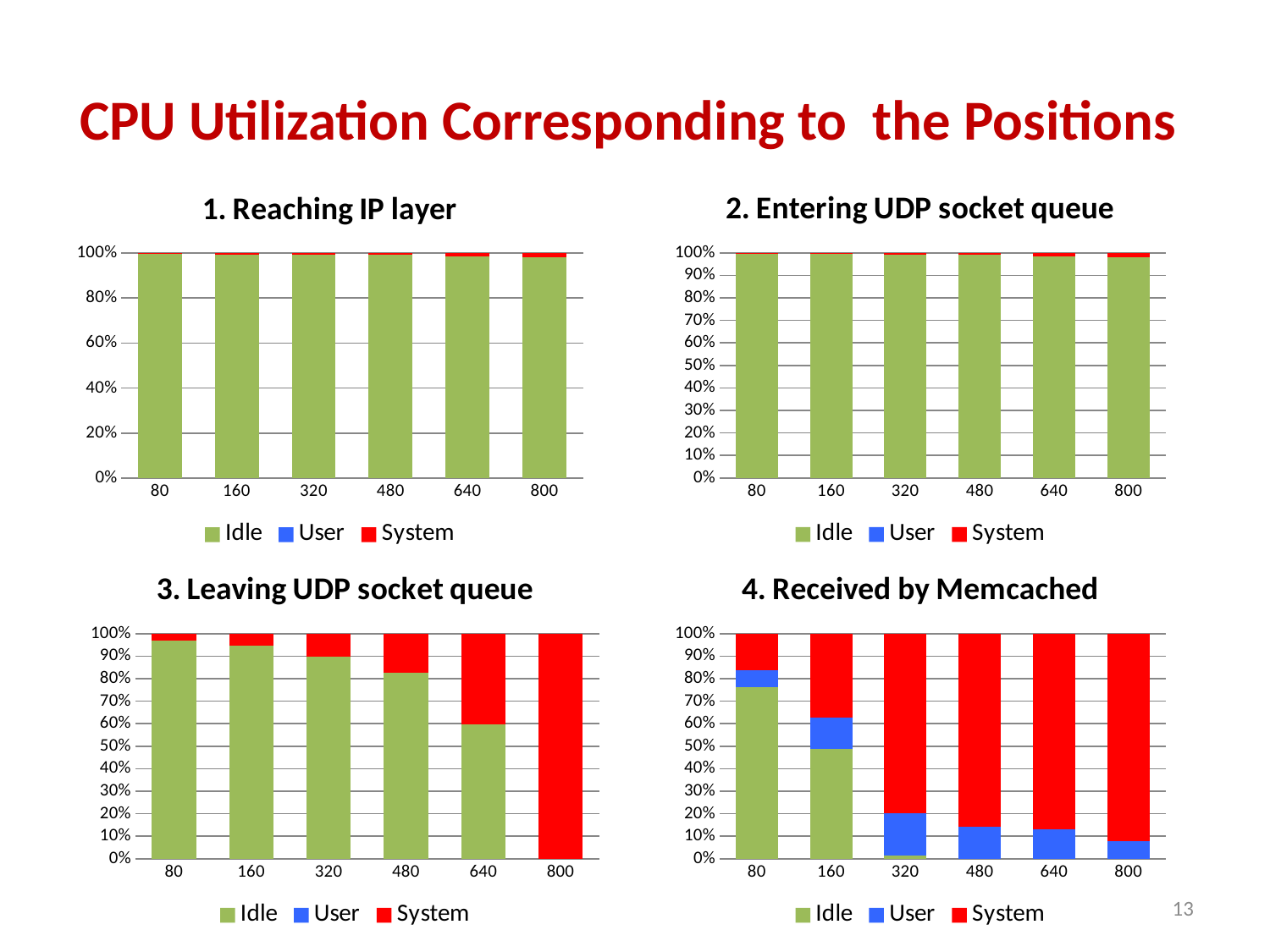
In the chart '3. Leaving UDP socket queue', is the Idle value for 800 greater or less than 10%? less In the chart '3. Leaving UDP socket queue', does the Idle share rise or fall as the x-axis value increases from 80 to 800? falls In the chart '4. Received by Memcached', which category has the highest Idle share? 80 In the chart '1. Reaching IP layer', how many categories are shown on the x axis? 6 In the chart '4. Received by Memcached', which has the larger Idle share, 80 or 160? 80 What is the title of the top-left chart on the slide? 1. Reaching IP layer In the chart '3. Leaving UDP socket queue', is the Idle value for 640 greater or less than 80%? less In the chart '4. Received by Memcached', is the Idle value for 80 greater or less than 50%? greater In the chart '2. Entering UDP socket queue', how many series does the legend list? 3 What are the legend entries in the chart '4. Received by Memcached'? Idle, User, System In the chart '3. Leaving UDP socket queue', which category has the lowest Idle share? 800 What kind of chart is '3. Leaving UDP socket queue'? stacked bar chart